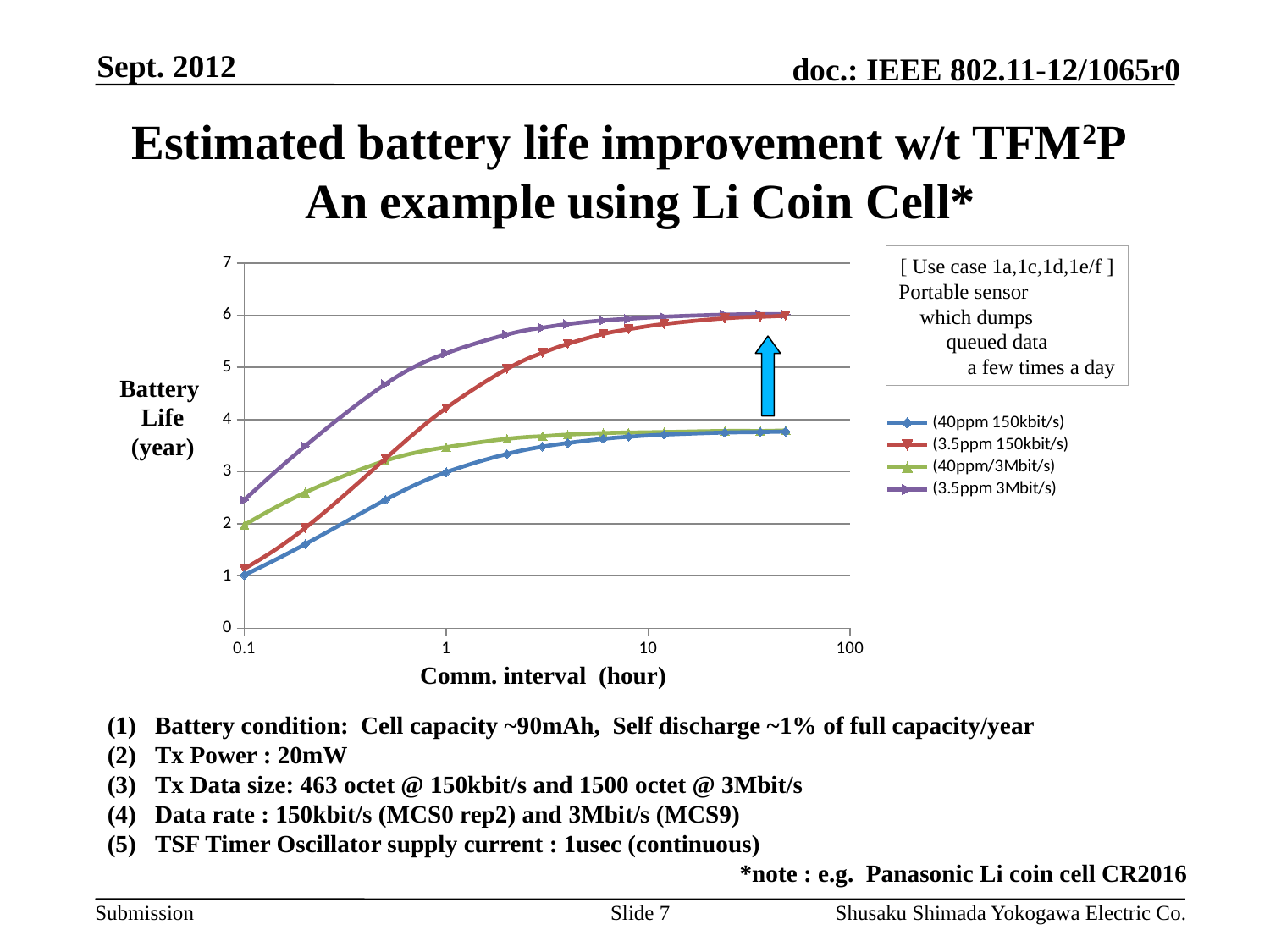
What kind of chart is shown on the slide? line chart At a comm. interval of 1 hour, which is larger: the value for (3.5ppm 3Mbit/s) or the value for (40ppm 150kbit/s)? (3.5ppm 3Mbit/s) Does the battery life for (40ppm 150kbit/s) rise or fall as the comm. interval increases? rise Is the value for (3.5ppm 150kbit/s) at a comm. interval of 10 hours greater or less than 5? greater Is the value for (40ppm/3Mbit/s) at a comm. interval of 1 hour greater or less than 3? greater Which series has the highest battery life at a comm. interval of 0.1 hour? (3.5ppm 3Mbit/s) Is the value for (40ppm 150kbit/s) at a comm. interval of 10 hours greater or less than 4? less What is the label of the y axis? Battery Life (year) What is the label of the x axis? Comm. interval (hour) How many series does the legend list? 4